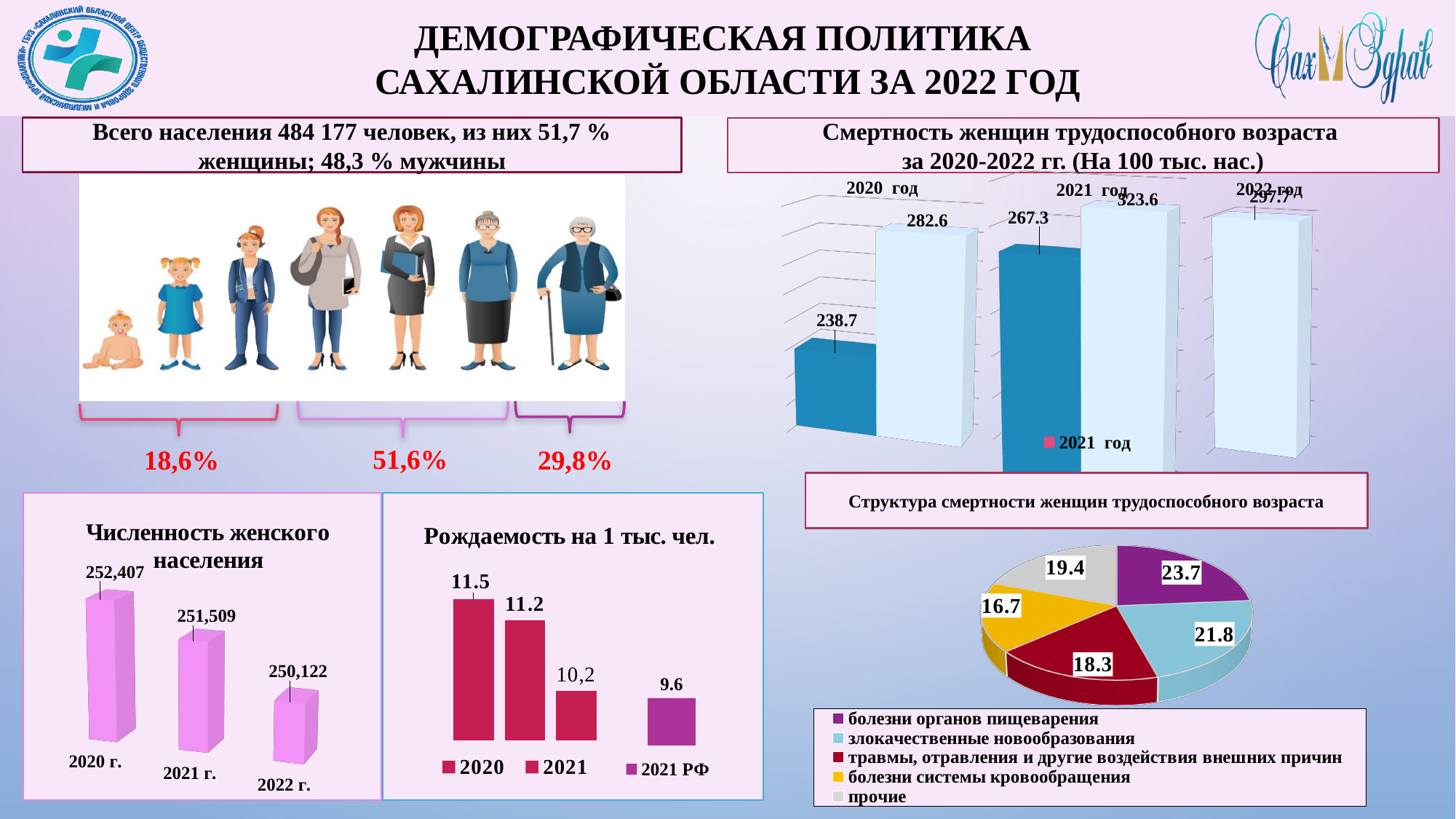
In the pie chart 'Структура смертности женщин трудоспособного возраста', what is the value for 'злокачественные новообразования'? 21.8 In the chart 'Рождаемость на 1 тыс. чел.', what is the difference between the 2020 value and the 2021 value? 0.3 In the chart 'Смертность женщин трудоспособного возраста за 2020-2022 гг.', what is the value of the dark blue bar in the 2020 год group? 238.7 In the chart 'Численность женского населения', what is the value for 2022 г.? 250,122 In the chart 'Численность женского населения', which year has the lowest value? 2022 г. In the chart 'Численность женского населения', what is the value for 2020 г.? 252,407 In the pie chart 'Структура смертности женщин трудоспособного возраста', which category has the largest slice? болезни органов пищеварения In the chart 'Рождаемость на 1 тыс. чел.', which bar is the highest? 2020 In the chart 'Рождаемость на 1 тыс. чел.', what is the value for 2021 РФ? 9.6 In the chart 'Численность женского населения', do the values rise or fall from 2020 г. to 2022 г.? fall How many slices does the pie chart 'Структура смертности женщин трудоспособного возраста' have? 5 In the chart 'Рождаемость на 1 тыс. чел.', what is the value for 2020? 11.5